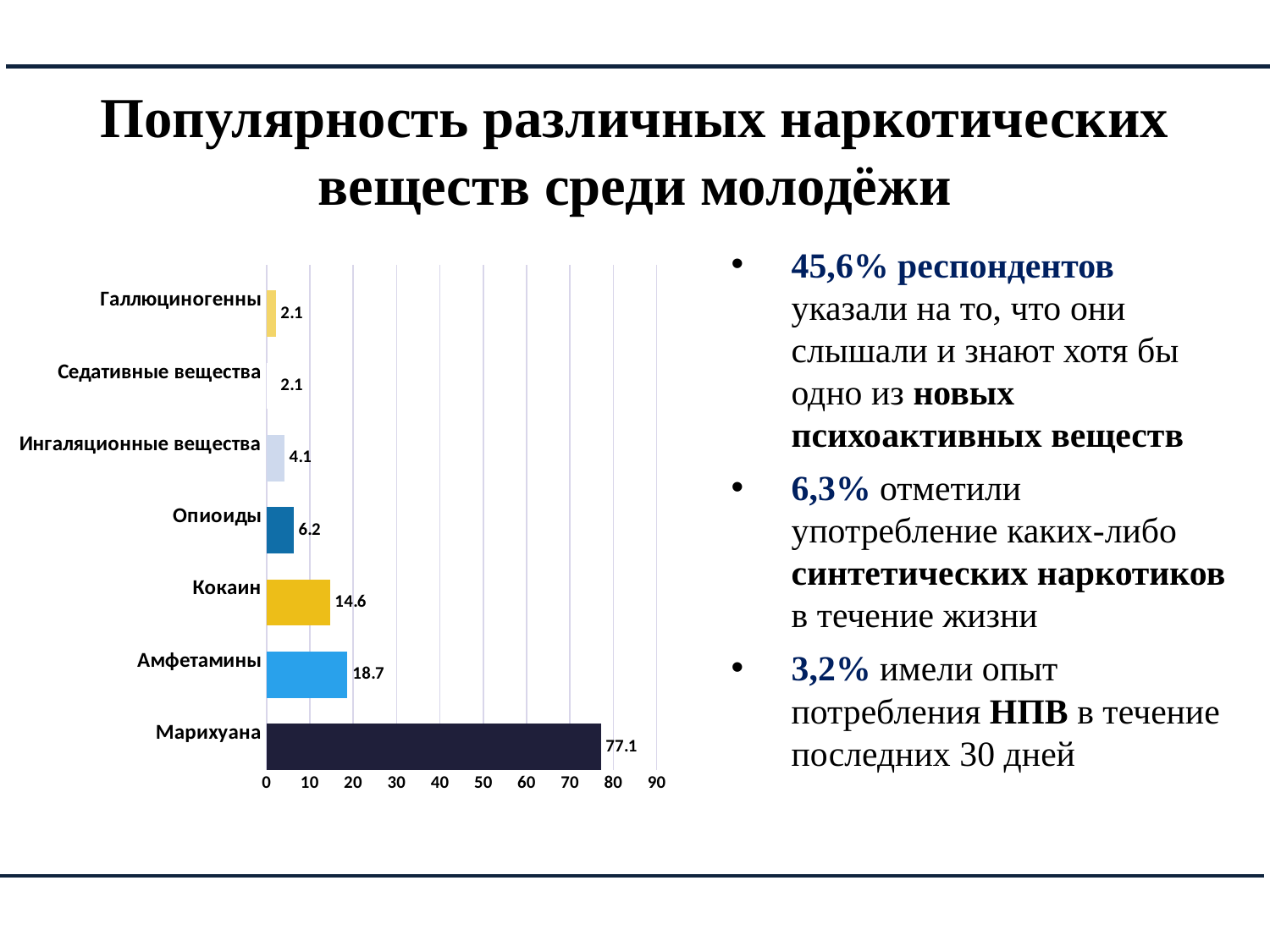
What is the difference between the values for Марихуана and Амфетамины? 58.4 What is the value for Марихуана? 77.1 What is the value for Амфетамины? 18.7 What kind of chart is shown on the slide? bar chart Which category has the highest value? Марихуана How many categories are shown in the chart? 7 What is the difference between the values for Амфетамины and Кокаин? 4.1 What is the value for Опиоиды? 6.2 Is the value for Марихуана greater or less than 70? greater What is the value for Кокаин? 14.6 Which is larger, the value for Кокаин or the value for Опиоиды? Кокаин What is the value for Ингаляционные вещества? 4.1